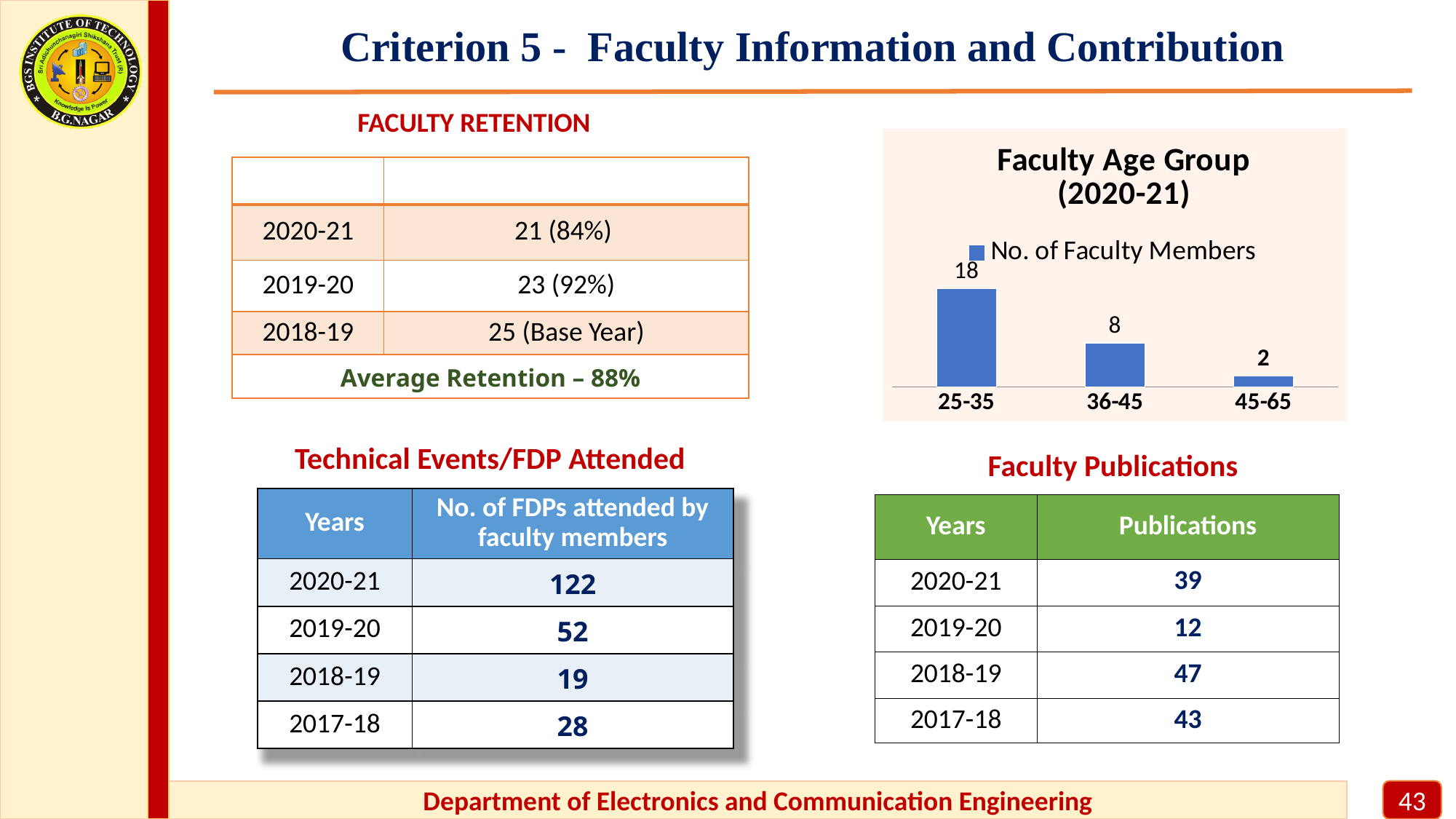
In the Faculty Age Group (2020-21) chart, which age group has the most faculty members? 25-35 In the Faculty Age Group (2020-21) chart, how many faculty members are in the 25-35 age group? 18 In the Faculty Age Group (2020-21) chart, which age group has the fewest faculty members? 45-65 In the Faculty Age Group (2020-21) chart, do the values rise or fall from the 25-35 group to the 45-65 group? fall How many age group categories are shown in the Faculty Age Group (2020-21) chart? 3 In the Faculty Age Group (2020-21) chart, how many faculty members are in the 45-65 age group? 2 What type of chart is the Faculty Age Group (2020-21) chart? bar chart In the Faculty Age Group (2020-21) chart, what is the difference between the number of faculty members in the 25-35 and 36-45 age groups? 10 In the Faculty Age Group (2020-21) chart, how many faculty members are in the 36-45 age group? 8 How many series does the legend of the Faculty Age Group (2020-21) chart list? 1 In the Faculty Age Group (2020-21) chart, which age group has more faculty members, 36-45 or 45-65? 36-45 What is the title of the chart on the slide? Faculty Age Group (2020-21)